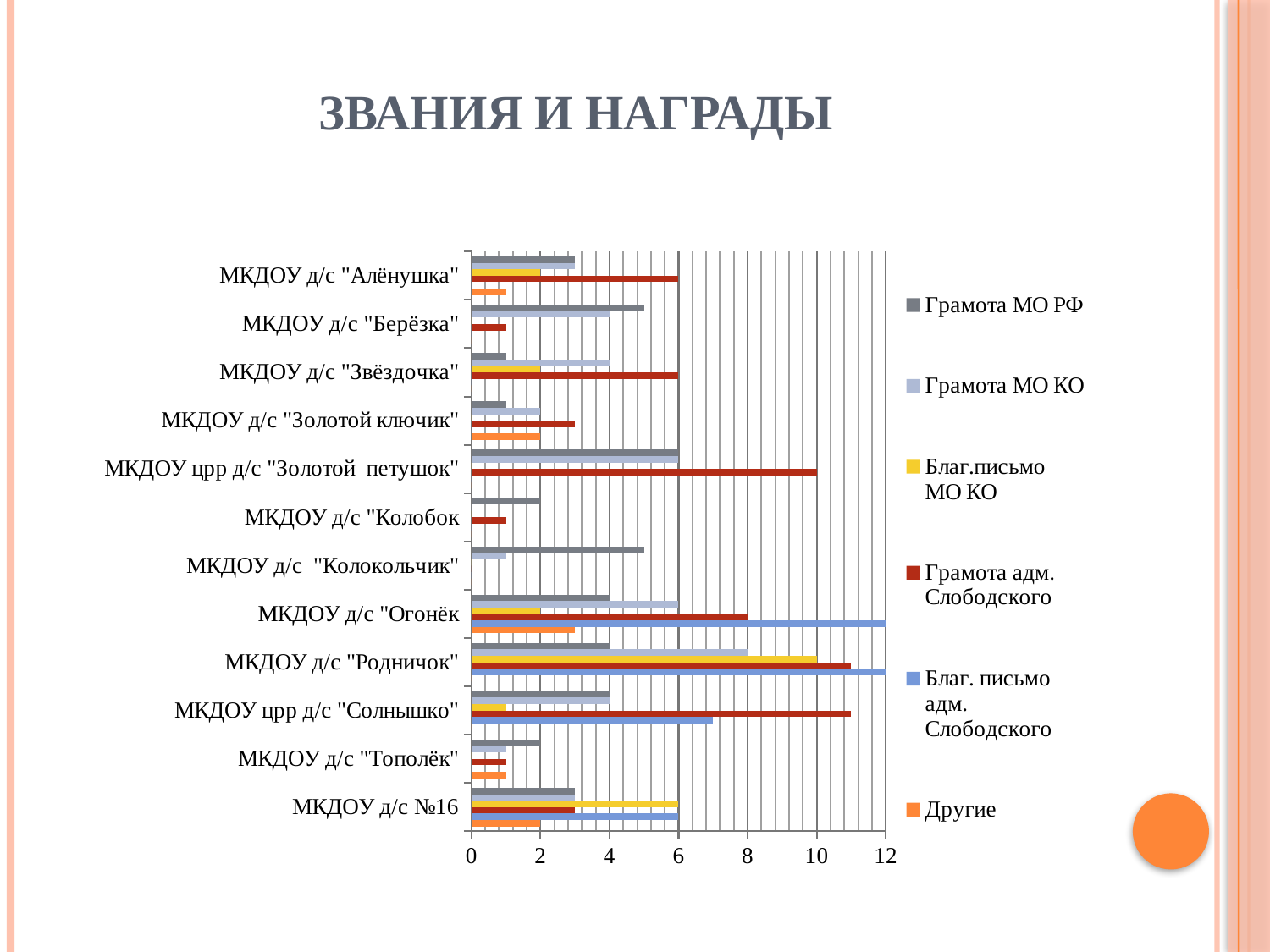
What is the value of "Грамота адм. Слободского" for МКДОУ црр д/с "Золотой петушок"? 10 How many institutions (categories) are listed on the vertical axis of the chart? 12 Which institution has the highest value for "Грамота МО РФ"? МКДОУ црр д/с "Золотой петушок" How many series does the chart legend list? 6 Is the "Грамота адм. Слободского" value for МКДОУ црр д/с "Солнышко" greater or less than 10? greater What is the value of "Благ.письмо МО КО" for МКДОУ д/с "Родничок"? 10 What is the value of "Благ. письмо адм. Слободского" for МКДОУ д/с №16? 6 What is the difference between the "Грамота адм. Слободского" values for МКДОУ д/с "Огонёк" and МКДОУ д/с "Алёнушка"? 2 What type of chart is shown on the slide? Bar chart What is the value of "Благ. письмо адм. Слободского" for МКДОУ д/с "Огонёк"? 12 What colour represents the "Другие" series in the legend? Orange Which has the larger "Грамота адм. Слободского" value: МКДОУ д/с "Алёнушка" or МКДОУ д/с "Берёзка"? МКДОУ д/с "Алёнушка"